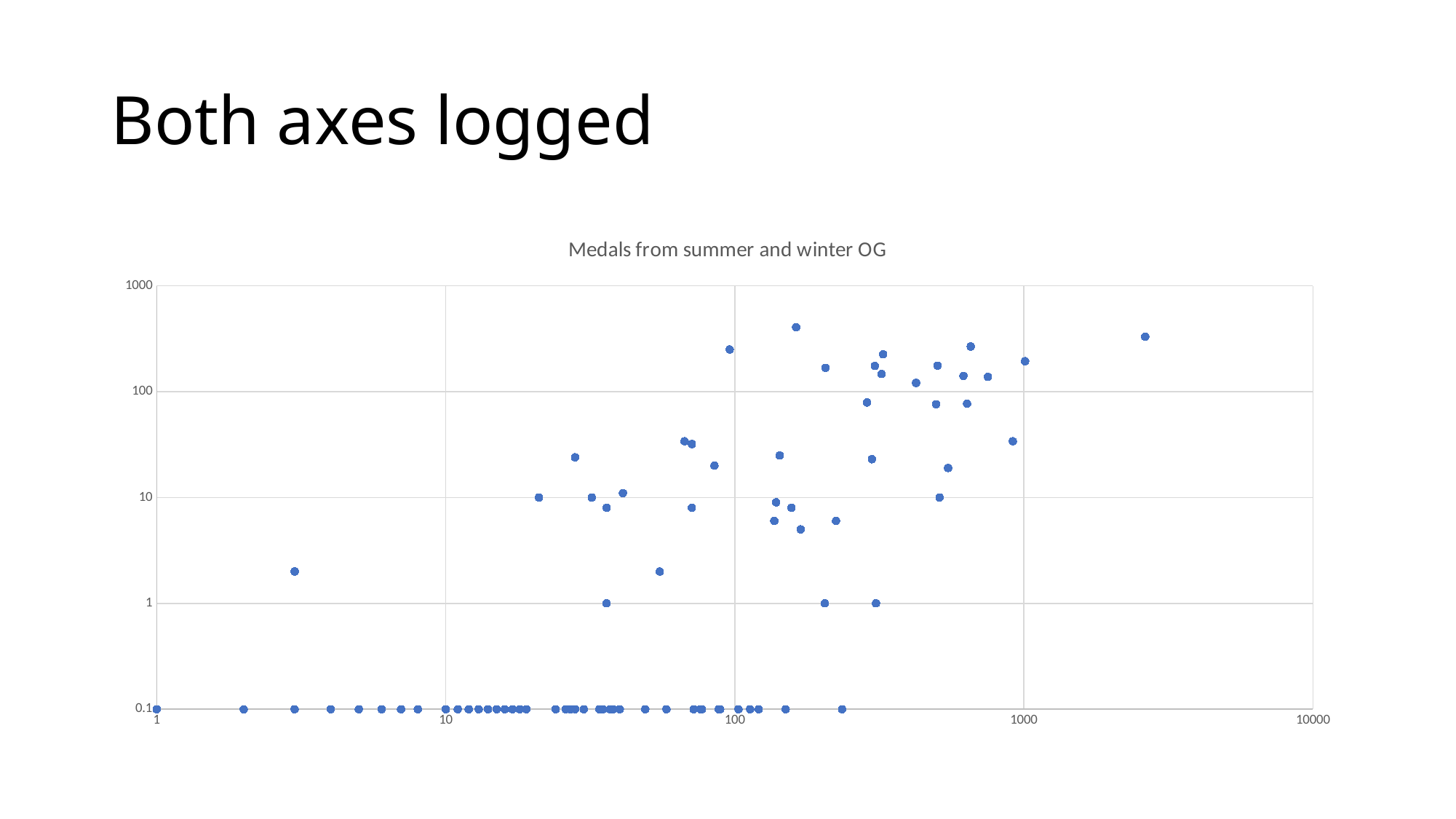
Do the plotted values generally rise or fall as you move to the right along the horizontal axis? rise Is the vertical-axis value of the highest plotted point greater or less than 1000? less Is the vertical-axis value of the highest plotted point greater or less than 100? greater What is the title of the chart? Medals from summer and winter OG What is the highest tick label shown on the vertical axis of the chart? 1000 Is the vertical-axis value of the rightmost plotted point greater or less than 100? greater What kind of chart is shown on the slide? scatter chart